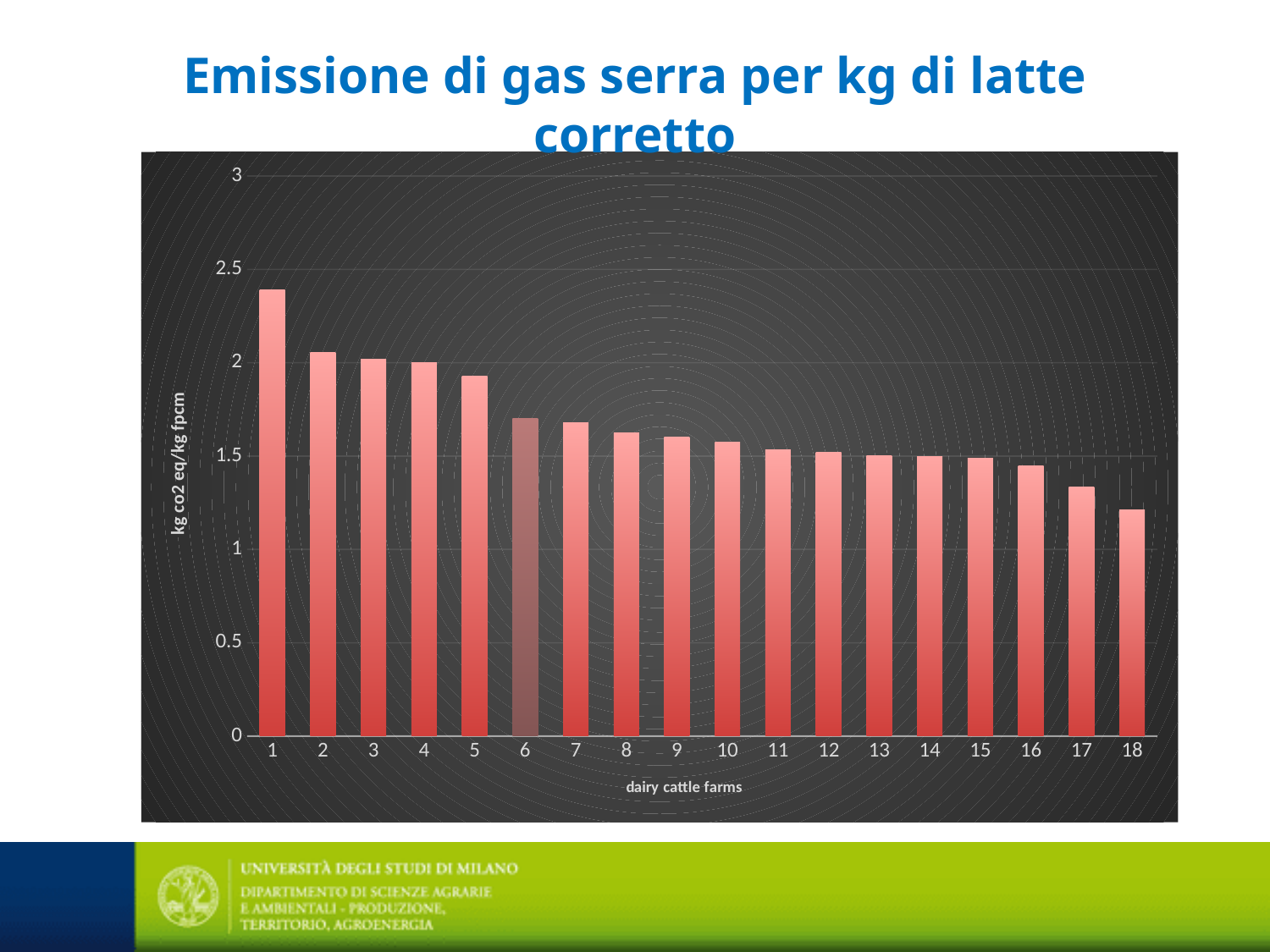
What kind of chart is shown on the slide? bar chart How many dairy cattle farms are plotted on the x axis? 18 Do the values rise or fall from farm 1 to farm 18 along the x axis? fall Is the value for farm 5 greater or less than 2? less Which dairy cattle farm has the highest emission value? 1 Is the value for farm 6 greater or less than 1.5? greater Is the value for farm 18 greater or less than 1.5? less Which dairy cattle farm has the lowest emission value? 18 What is the label on the x axis? dairy cattle farms Which has the larger value, farm 5 or farm 10? farm 5 What is the label on the y axis? kg co2 eq/kg fpcm